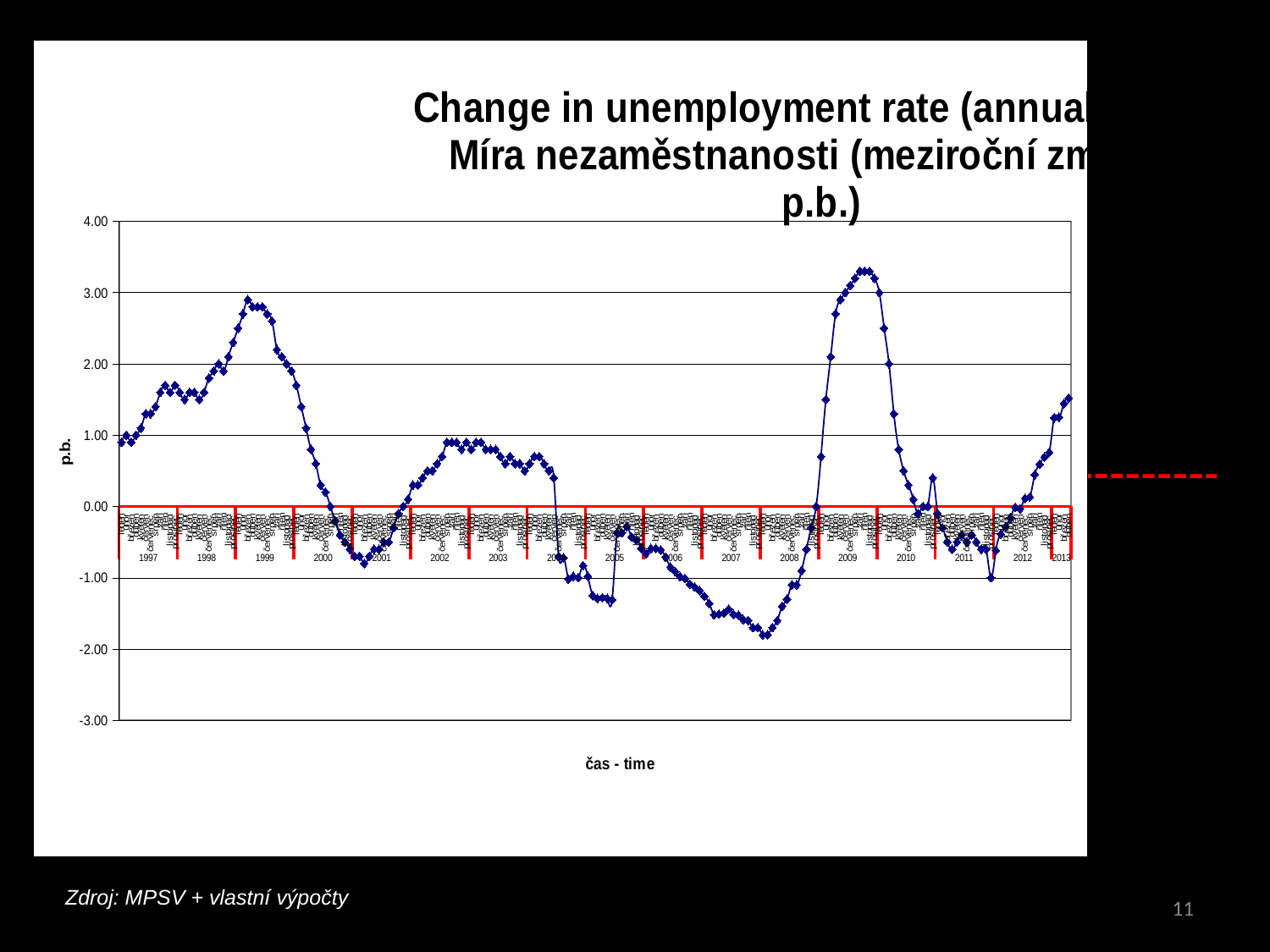
Does the line rise or fall between the 1999 peak and the end of 2000? fall Is the peak value reached in 1999 greater or less than 2.00? greater What is the label of the horizontal axis? čas - time In which year does the line reach its highest value? 2009 Are the values during 2007 greater or less than -1.00? less Does the line rise or fall from the end of 2008 to the middle of 2009? rise In which year does the line reach its lowest value? 2008 Is the lowest value reached in 2008 greater or less than -1.00? less What is the label of the vertical axis? p.b. How many year labels are shown along the horizontal axis? 17 What kind of chart is shown on the slide? line chart